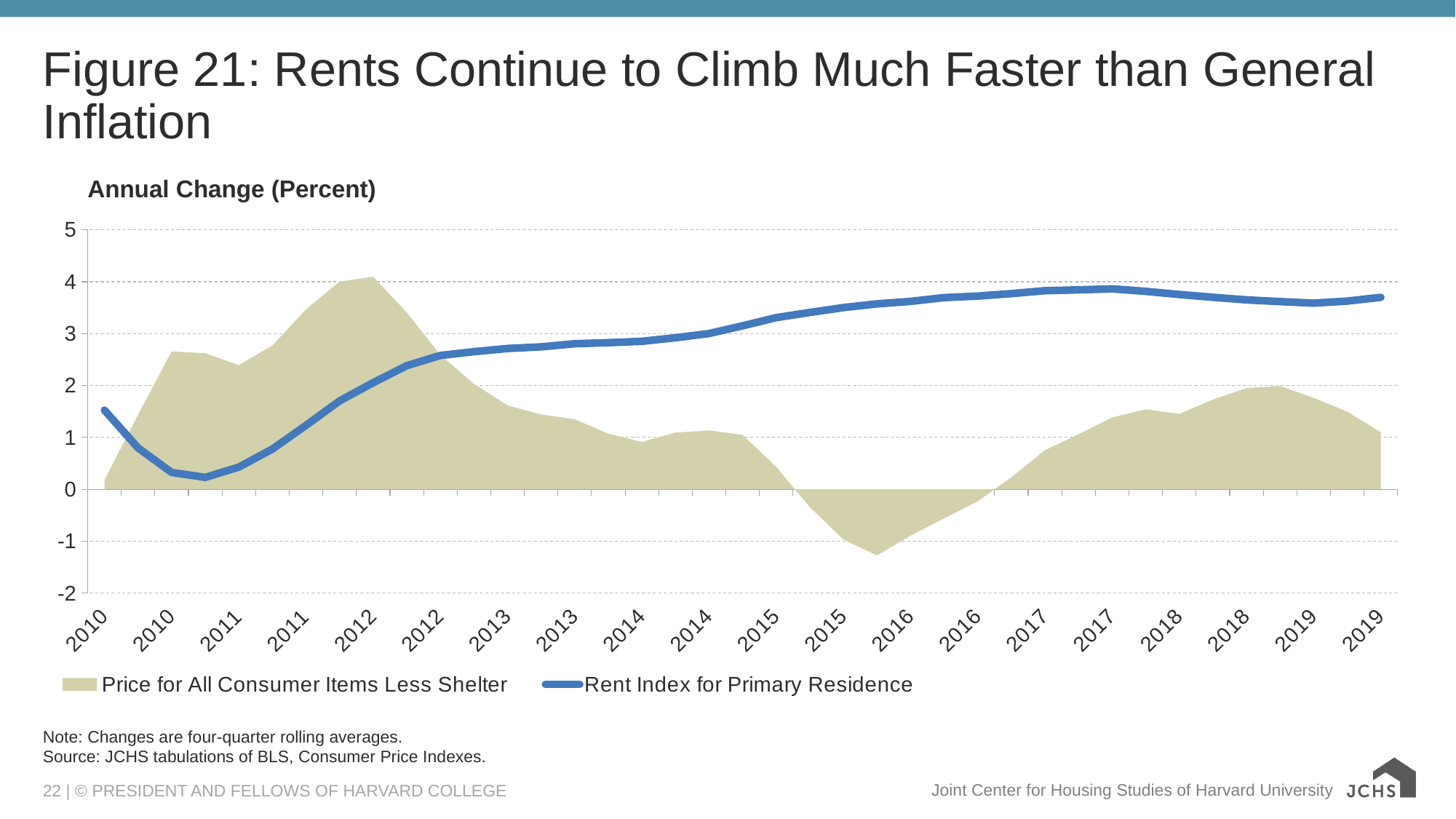
At the first 2012 point, which series has the higher value: Price for All Consumer Items Less Shelter or Rent Index for Primary Residence? Price for All Consumer Items Less Shelter Is the value of Price for All Consumer Items Less Shelter at the second 2015 point greater or less than 0? less Is the value of Price for All Consumer Items Less Shelter at the first 2012 point greater or less than 3? greater What is the label on the vertical axis of the chart? Annual Change (Percent) How many series does the legend list? 2 Does the Rent Index for Primary Residence rise or fall between 2011 and 2017? rise What kind of chart is shown on the slide? A combined area and line chart At the last 2019 point, which series has the higher value: Price for All Consumer Items Less Shelter or Rent Index for Primary Residence? Rent Index for Primary Residence Which series reaches the lowest value anywhere on the chart? Price for All Consumer Items Less Shelter What are the two series named in the legend? Price for All Consumer Items Less Shelter; Rent Index for Primary Residence Is the value of the Rent Index for Primary Residence at the last 2019 point greater or less than 3? greater